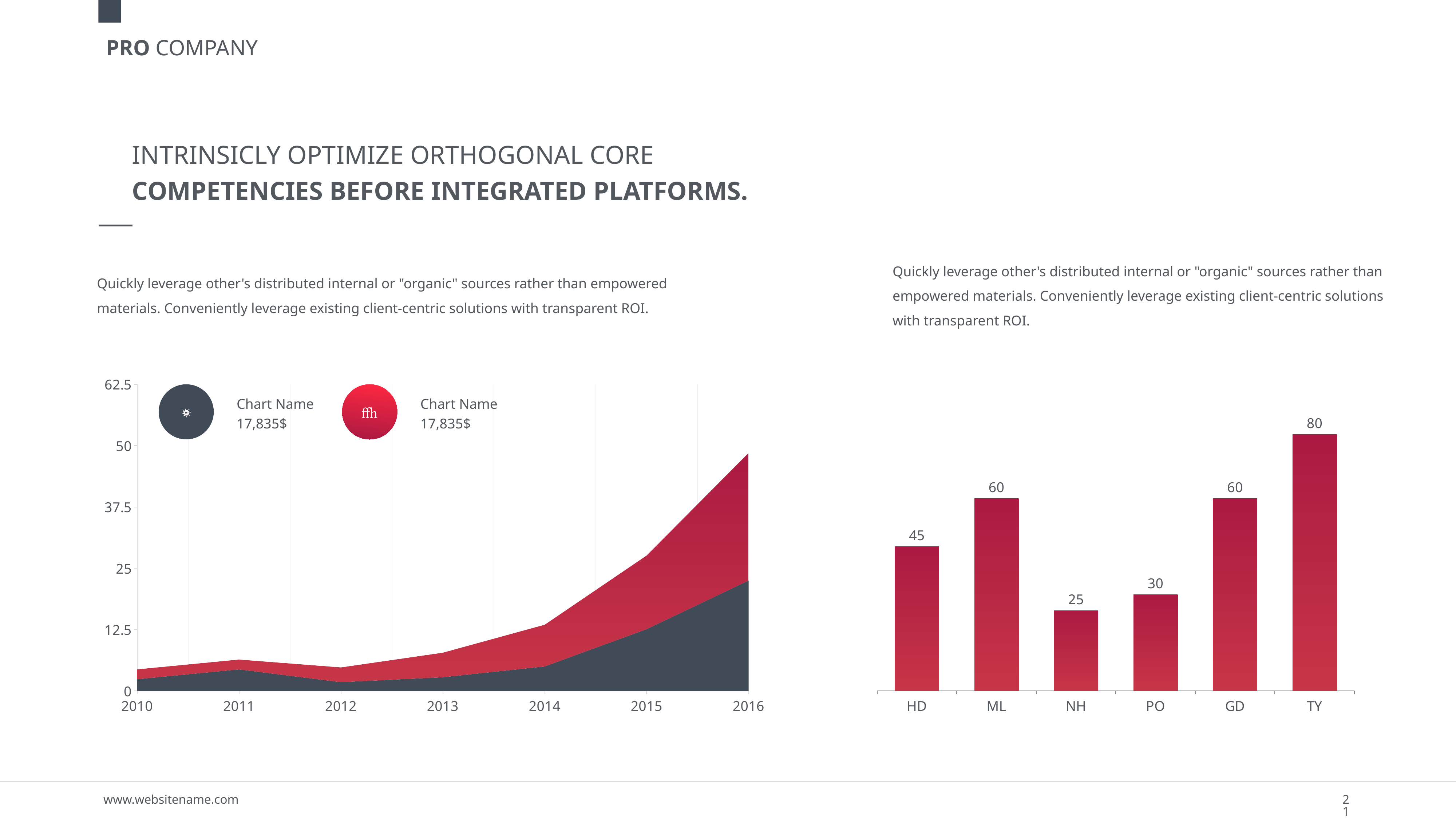
What kind of chart is the chart on the right? bar chart In the area chart on the left, is the total stacked value in 2015 greater or less than 25? greater In the bar chart on the right, which category has the highest value? TY In the bar chart on the right, which category has the lowest value? NH In the area chart on the left, does the total stacked value rise or fall from 2013 to 2016? rise In the bar chart on the right, what is the value for NH? 25 In the bar chart on the right, what is the value for TY? 80 In the bar chart on the right, which is larger, the value for PO or the value for GD? GD How many years are shown on the x axis of the area chart on the left? 7 How many categories are shown in the bar chart on the right? 6 What kind of chart is the chart on the left? stacked area chart In the bar chart on the right, what is the difference between the values for ML and HD? 15